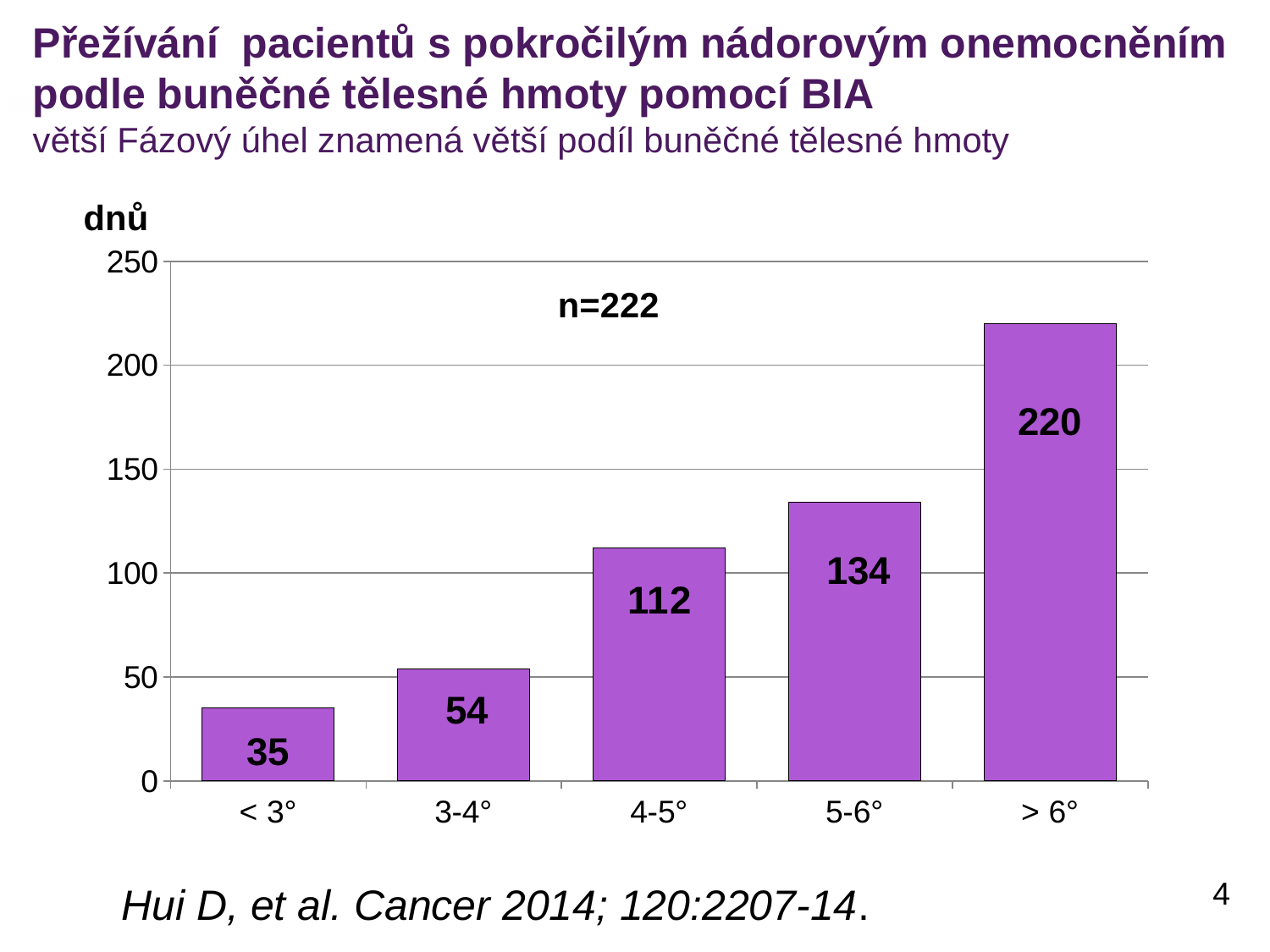
What is the value for the > 6° category? 220 Is the value for 5-6° greater or less than 150? less How many categories are shown on the x axis? 5 Which category has the highest value? > 6° What is the value for the 4-5° category? 112 Which is larger, the value for 4-5° or the value for 5-6°? 5-6° What kind of chart is shown on the slide? bar chart Which category has the lowest value? < 3° Do the values rise or fall from left to right along the x axis? rise What is the value for the < 3° category? 35 What is the difference between the values for > 6° and 5-6°? 86 What is the difference between the values for 3-4° and < 3°? 19